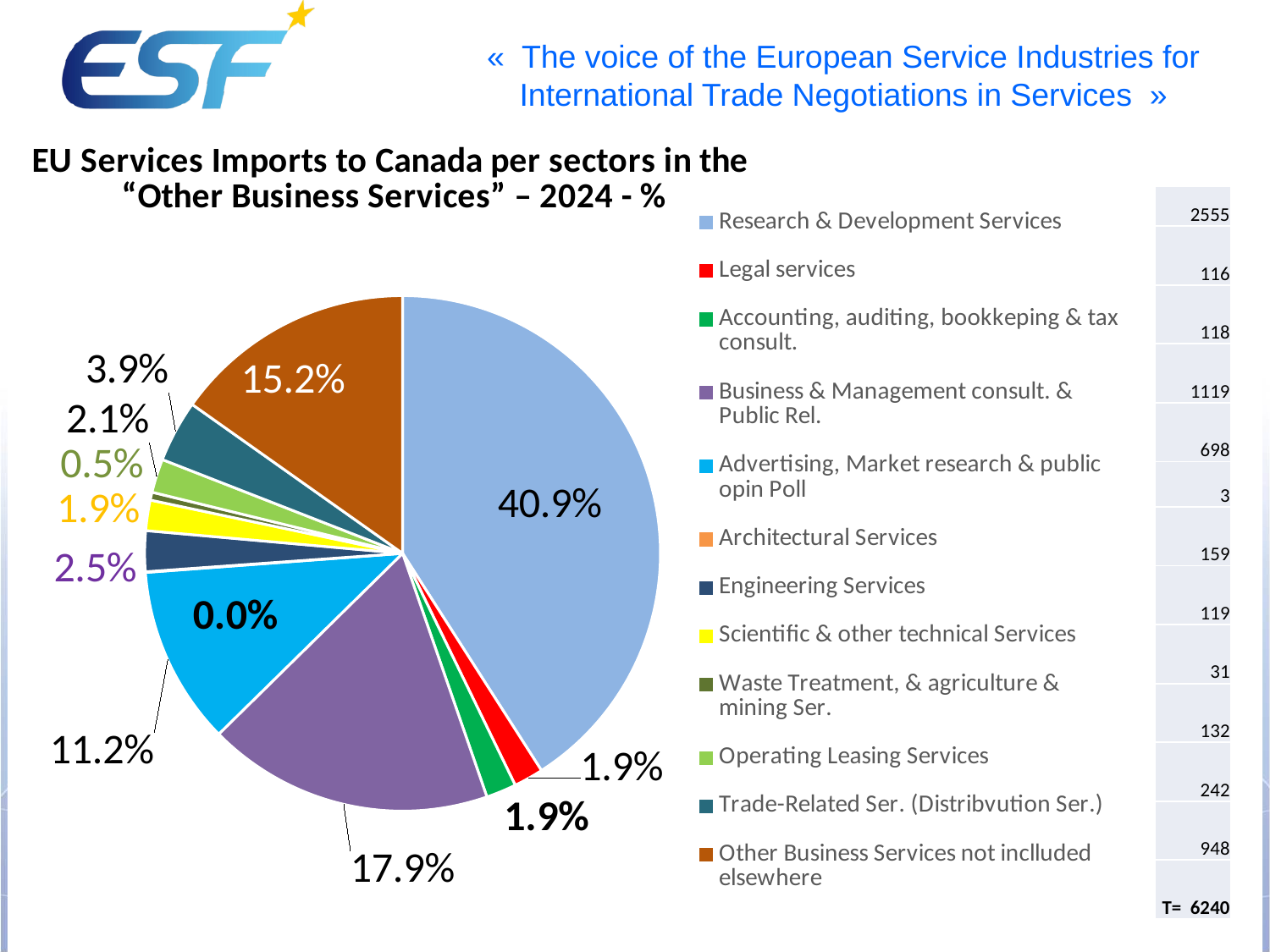
Which sector has the smallest share in the pie chart? Architectural Services What year does the chart title refer to? 2024 What percentage is shown for Other Business Services not included elsewhere? 15.2% How many sectors does the legend list? 12 What share of EU services imports to Canada in Other Business Services is Research & Development Services? 40.9% What percentage is shown for Business & Management consult. & Public Rel.? 17.9% What is the difference in percentage points between Research & Development Services and Business & Management consult. & Public Rel.? 23.0 percentage points Which has the larger share: Advertising, Market research & public opin Poll or Other Business Services not included elsewhere? Other Business Services not included elsewhere What percentage is shown for Advertising, Market research & public opin Poll? 11.2% Which sector has the largest share in the pie chart? Research & Development Services What percentage is shown for Trade-Related Ser. (Distribution Ser.)? 3.9% What type of chart is shown on the slide? Pie chart